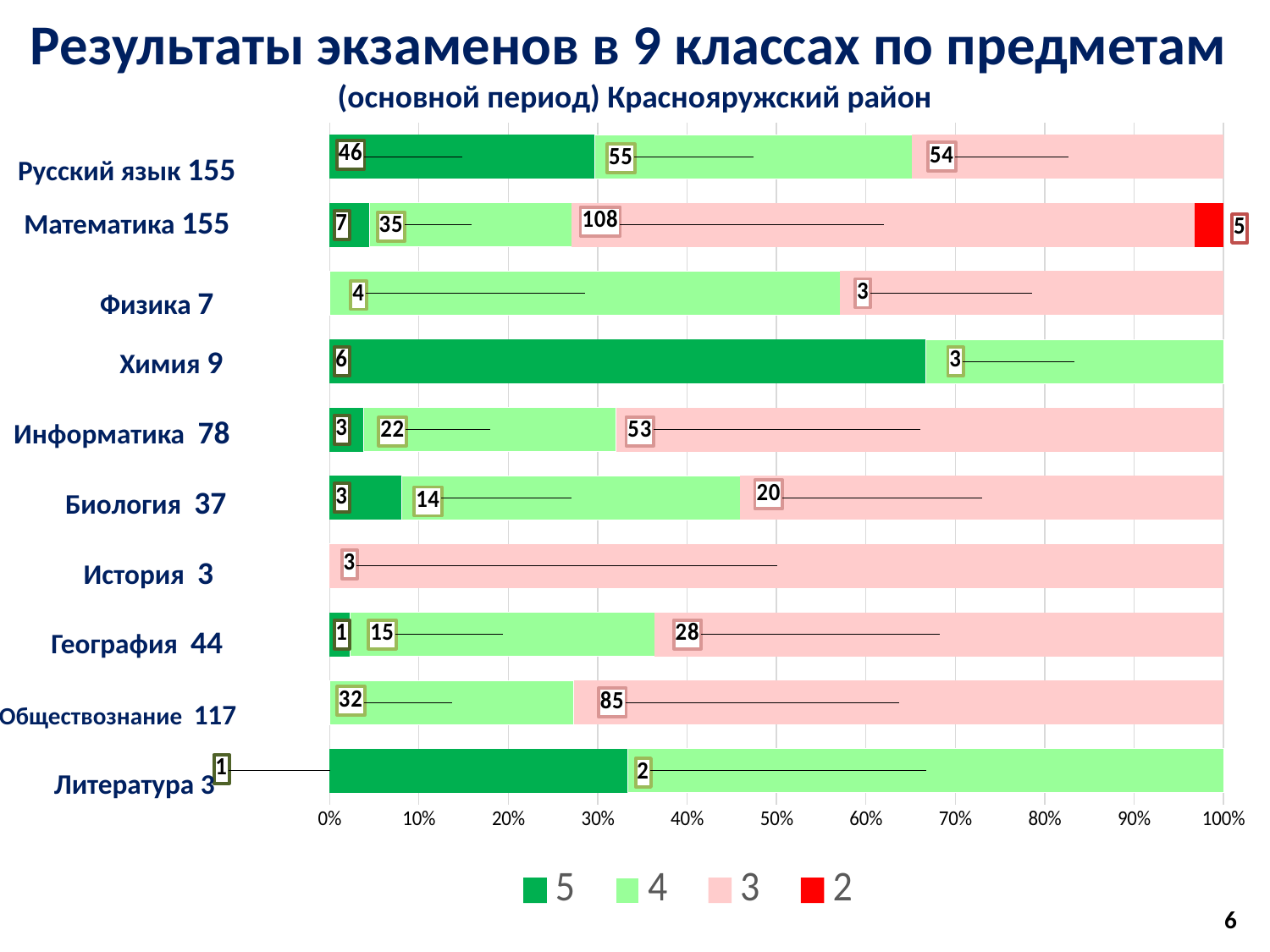
How many subjects (categories) are shown on the chart? 10 Is the share of grade 5 in Химия greater or less than 60%? greater What is the difference between the number of grade 3 and grade 4 results in География? 13 What is the total number of students shown for Биология (sum of the bar segments)? 37 How many series does the legend list? 4 How many students received a grade of 5 in Русский язык? 46 Which has more students: grade 4 in Русский язык or grade 3 in Русский язык? grade 4 (55) How many students received a grade of 3 in Обществознание? 85 How many students received a grade of 2 in Математика? 5 How many students received a grade of 3 in Математика? 108 Which subject is the only one with a grade 2 segment? Математика How many students received a grade of 4 in Информатика? 22